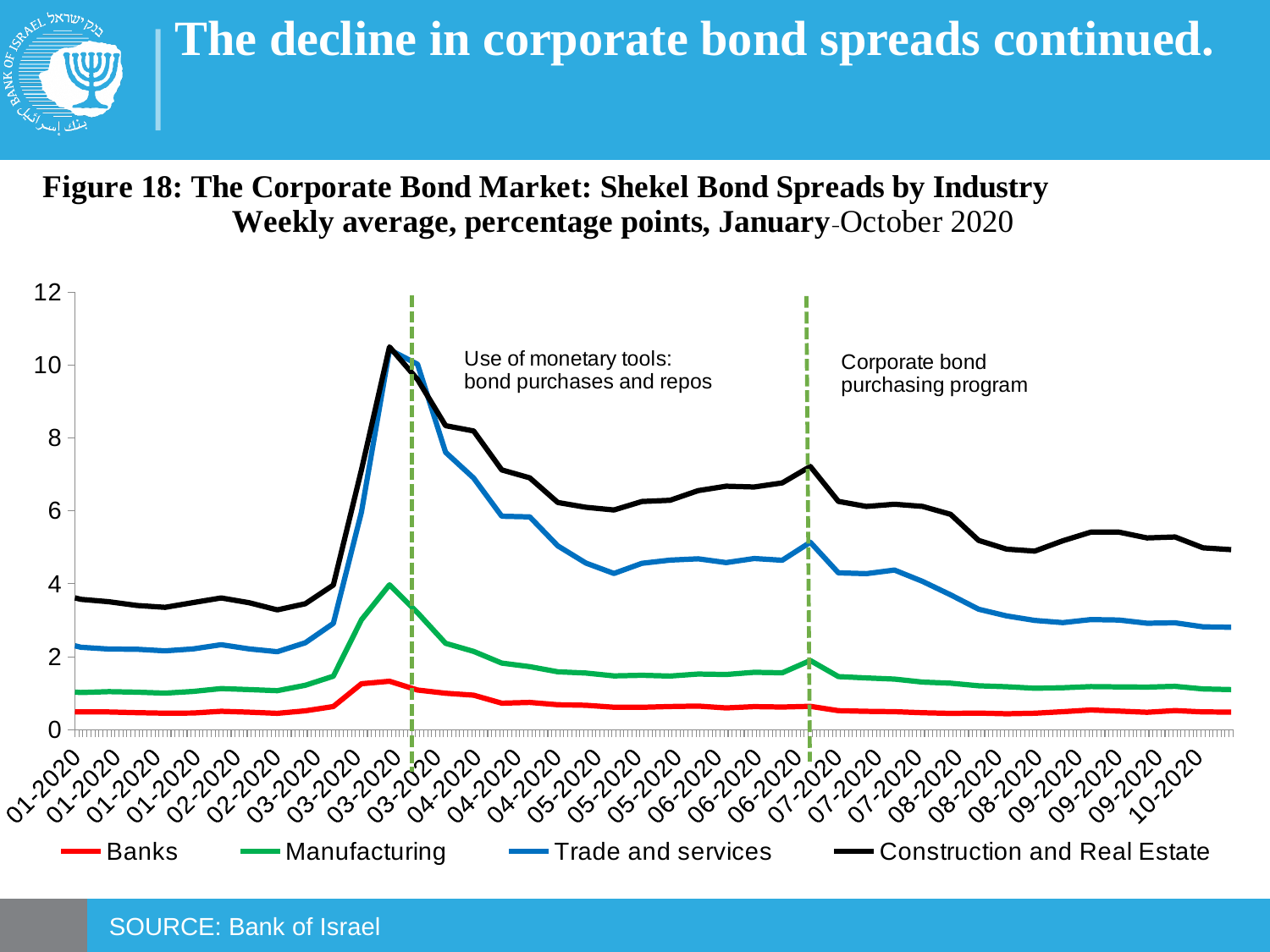
Is the value for Construction and Real Estate at the end of the period (10-2020) greater or less than 6? less Is the value for Trade and services at the end of the period (10-2020) greater or less than 2? greater How many series does the legend list? 4 What kind of chart is shown on the slide? line chart What event does the first dashed vertical line mark? Use of monetary tools: bond purchases and repos Is the peak value for Manufacturing greater or less than 3? greater Which industry has the lowest bond spread throughout the period? Banks From the March 2020 peak to October 2020, does the Construction and Real Estate spread rise or fall? fall At the end of the period (10-2020), which is larger: the spread for Trade and services or for Manufacturing? Trade and services